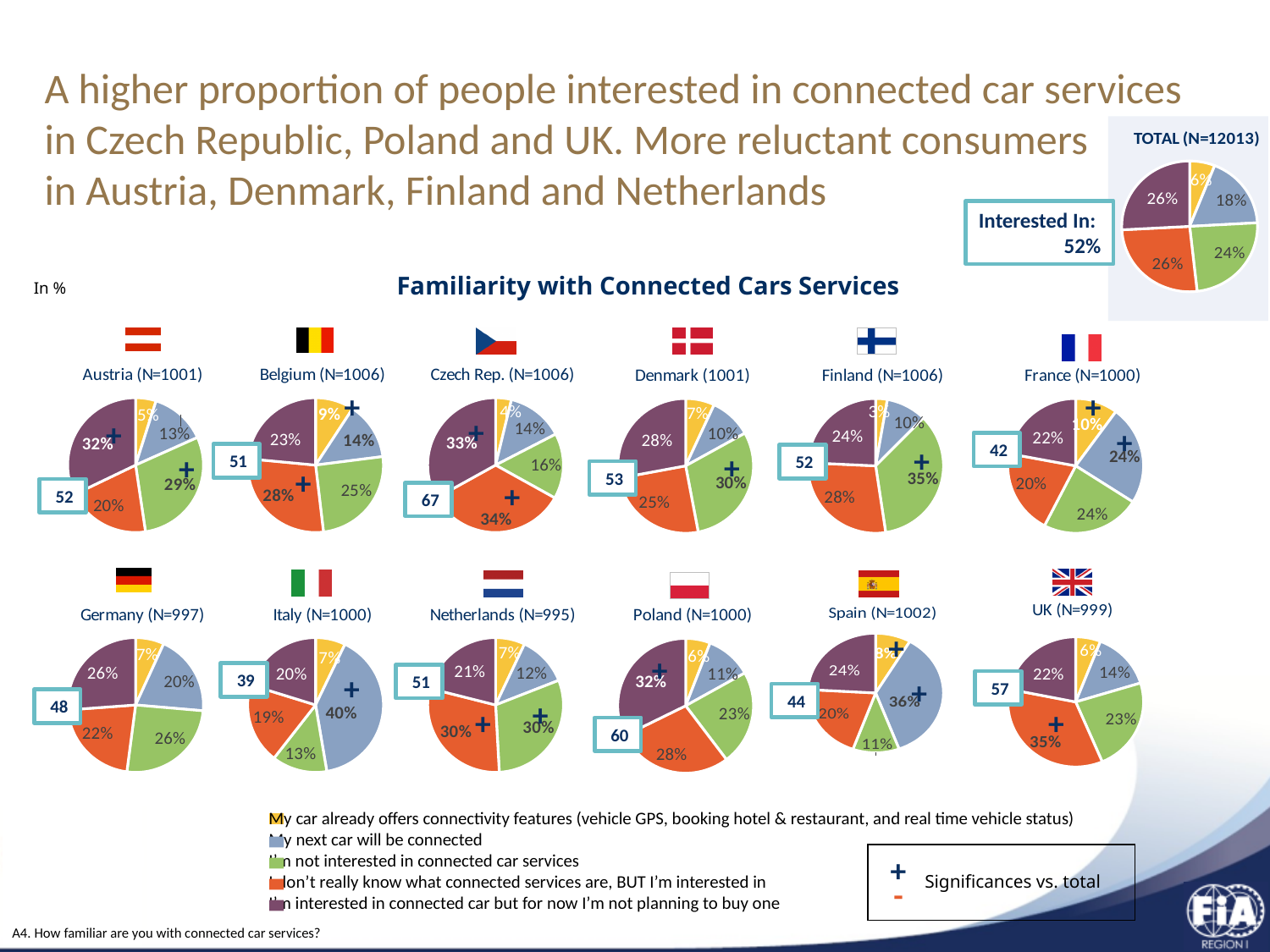
In the TOTAL (N=12013) pie chart, what is the value of the smallest slice? 6% What number is shown in the box next to the France (N=1000) pie chart? 42 What kind of charts are used on the slide to show familiarity with connected car services? Pie charts In the TOTAL (N=12013) pie chart, what is the 'Interested In' percentage shown in the box? 52% In the Czech Rep. (N=1006) pie chart, what is the value of the largest slice? 34% What is the difference between the boxed numbers for UK (57) and Italy (39)? 18 What number is shown in the box next to the Poland (N=1000) pie chart? 60 In the Finland (N=1006) pie chart, what is the value of the smallest slice? 3% How many response categories does the legend list for the pie charts? 5 Which country has the higher boxed number, Czech Rep. or Germany? Czech Rep. In the Italy (N=1000) pie chart, what is the value of the largest slice? 40% How many country pie charts are shown under the title 'Familiarity with Connected Cars Services'? 12